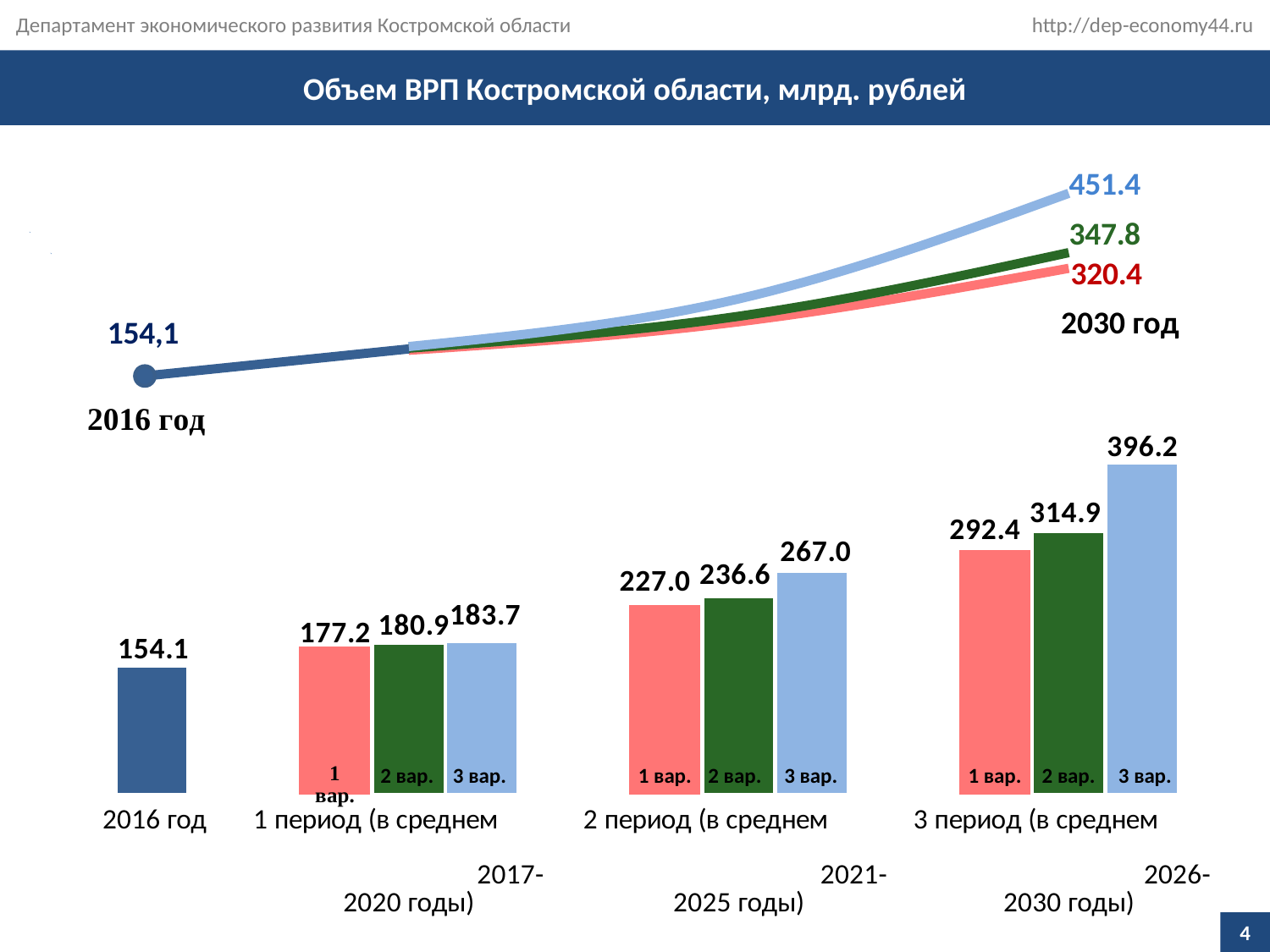
In the bottom bar chart, what is the value of 2 вар. in 1 период (2017-2020 годы)? 180.9 In the top line chart, what is the value of the light blue line at 2030 год? 451.4 In the bottom bar chart, what is the value of 3 вар. in 3 период (2026-2030 годы)? 396.2 In the bottom bar chart, what is the value for 2016 год? 154.1 In the bottom bar chart, which bar has the lowest value? 2016 год In the bottom bar chart, which is larger in 2 период: 2 вар. or 3 вар.? 3 вар. In the top line chart, what is the value of the red line at 2030 год? 320.4 In the bottom bar chart, what is the difference between 3 вар. and 1 вар. in 3 период (2026-2030 годы)? 103.8 In the bottom bar chart, what is the value of 1 вар. in 2 период (2021-2025 годы)? 227.0 What is the title of the slide's chart? Объем ВРП Костромской области, млрд. рублей In the bottom bar chart, which bar has the highest value? 3 вар. in 3 период (2026-2030 годы) In the top line chart, what is the difference between the green line value and the red line value at 2030 год? 27.4